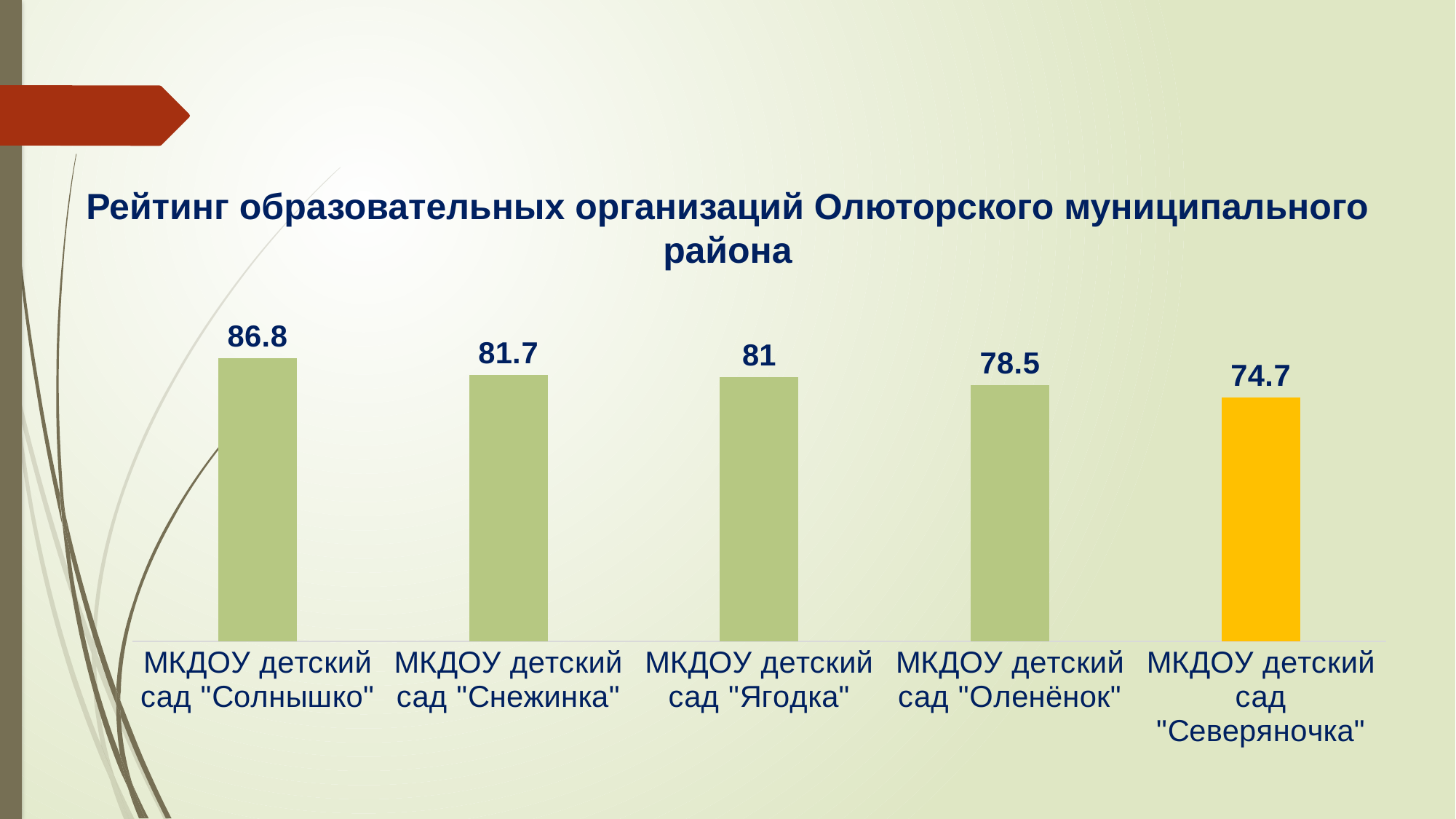
What is the value for МКДОУ детский сад "Ягодка"? 81 Do the values rise or fall from left to right across the chart? Fall What is the value for МКДОУ детский сад "Солнышко"? 86.8 How many organisations are shown in the chart? 5 Which organisation has the highest value? МКДОУ детский сад "Солнышко" Which organisation has the lowest value? МКДОУ детский сад "Северяночка" What kind of chart is shown on the slide? Bar chart What is the value for МКДОУ детский сад "Снежинка"? 81.7 What is the difference between the values for МКДОУ детский сад "Солнышко" and МКДОУ детский сад "Северяночка"? 12.1 Which has a larger value, МКДОУ детский сад "Снежинка" or МКДОУ детский сад "Оленёнок"? МКДОУ детский сад "Снежинка" What is the value for МКДОУ детский сад "Оленёнок"? 78.5 What is the value for МКДОУ детский сад "Северяночка"? 74.7